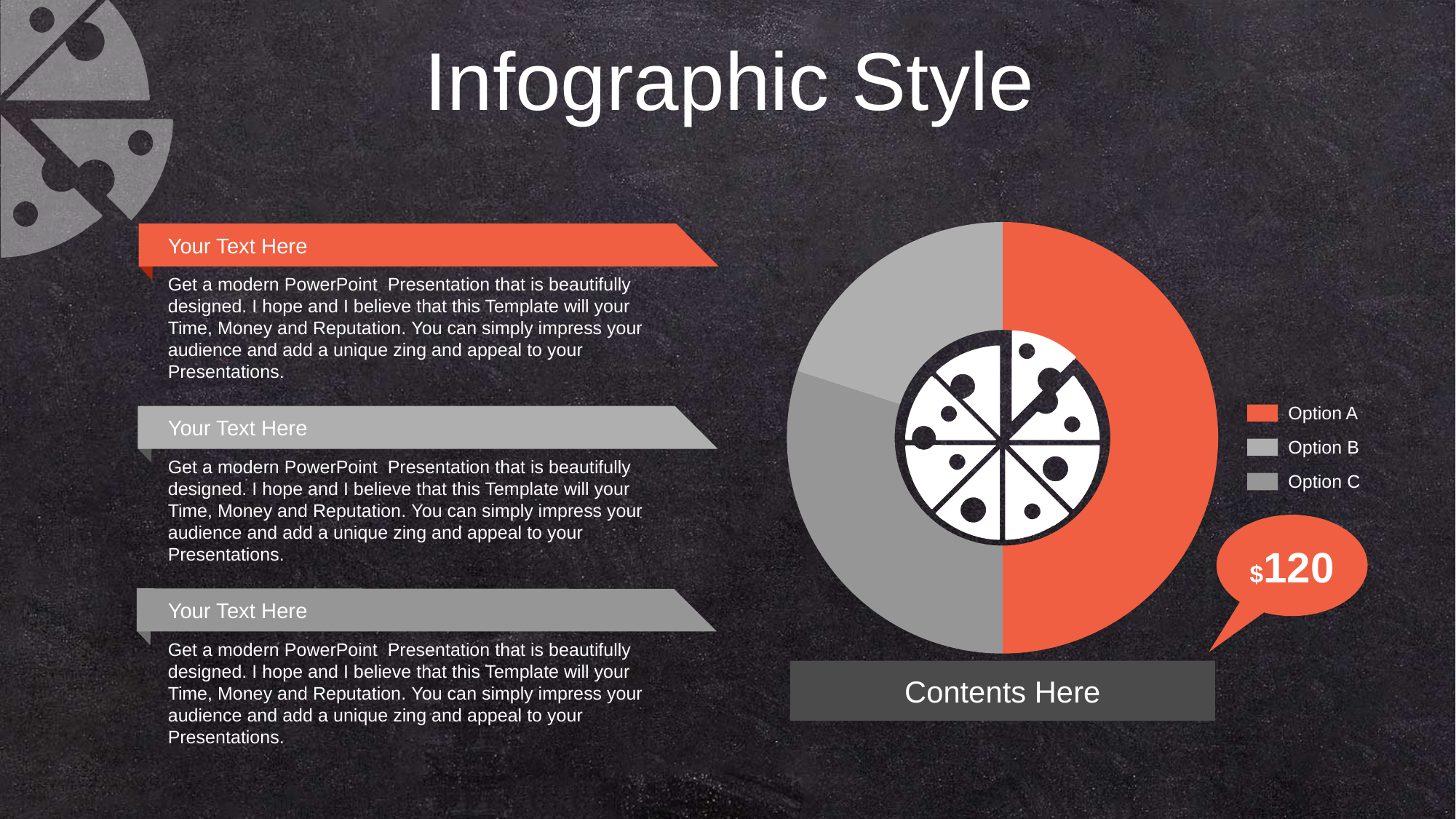
Which option has the largest slice in the doughnut chart? Option A What are the legend entries of the doughnut chart? Option A, Option B, Option C What kind of chart is shown on the slide? doughnut chart What colour is the Option A slice in the doughnut chart? orange How many entries does the legend of the doughnut chart list? 3 How many categories does the doughnut chart show? 3 Which slice is larger in the doughnut chart, Option A or Option C? Option A